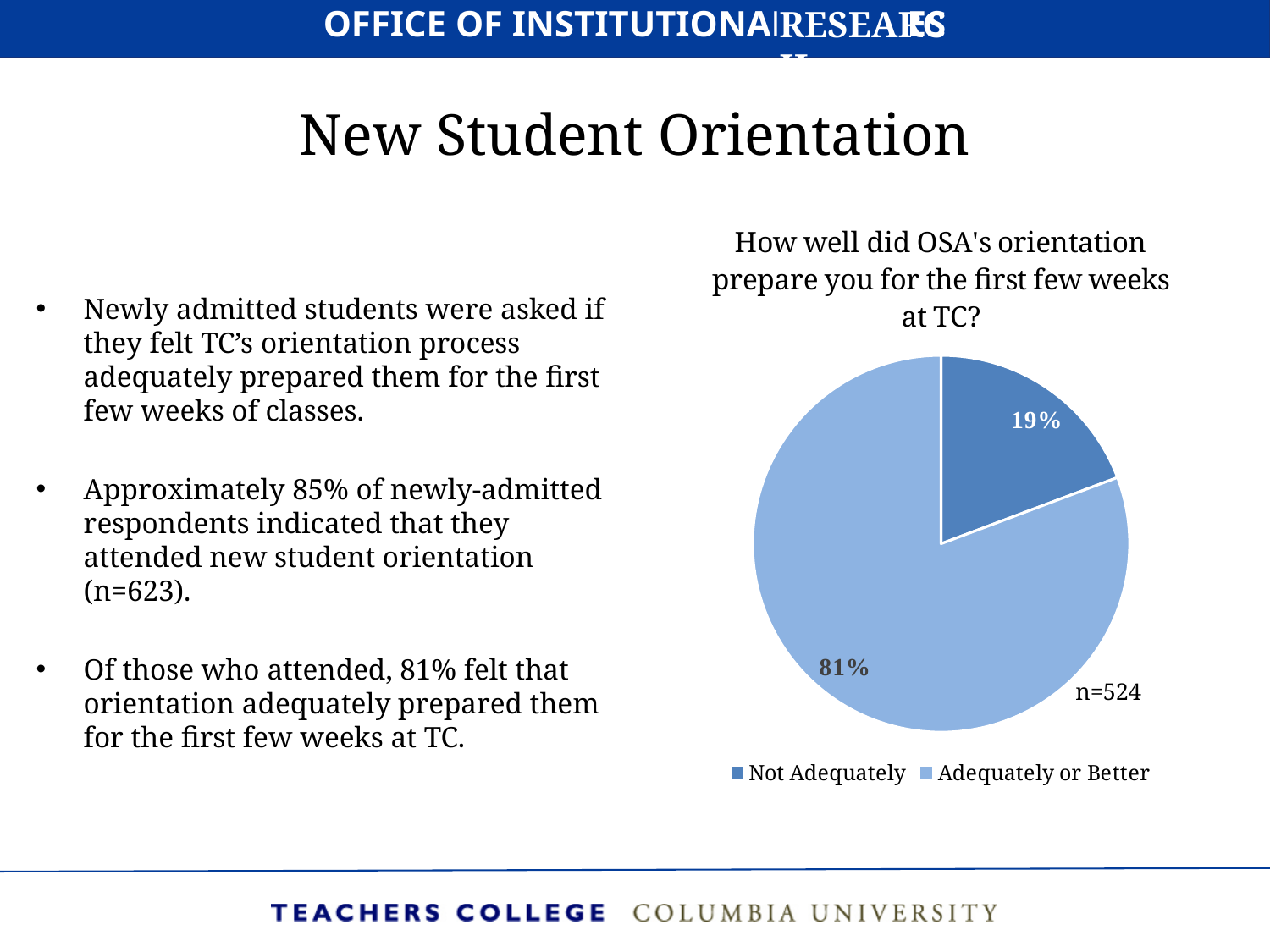
How many slices does the pie chart have? 2 What share of the pie does the Not Adequately slice represent? 19% What percentage of respondents said the orientation prepared them Adequately or Better? 81% Which category has the smallest share of the pie? Not Adequately What is the title of the pie chart? How well did OSA's orientation prepare you for the first few weeks at TC? Which category has the largest share of the pie? Adequately or Better What percentage of respondents said the orientation prepared them Not Adequately? 19% What sample size (n) is shown on the pie chart? n=524 What is the difference in percentage points between the Adequately or Better and Not Adequately slices? 62 Which slice is larger: Not Adequately or Adequately or Better? Adequately or Better How many entries does the chart legend list? 2 What kind of chart is shown on the slide? pie chart